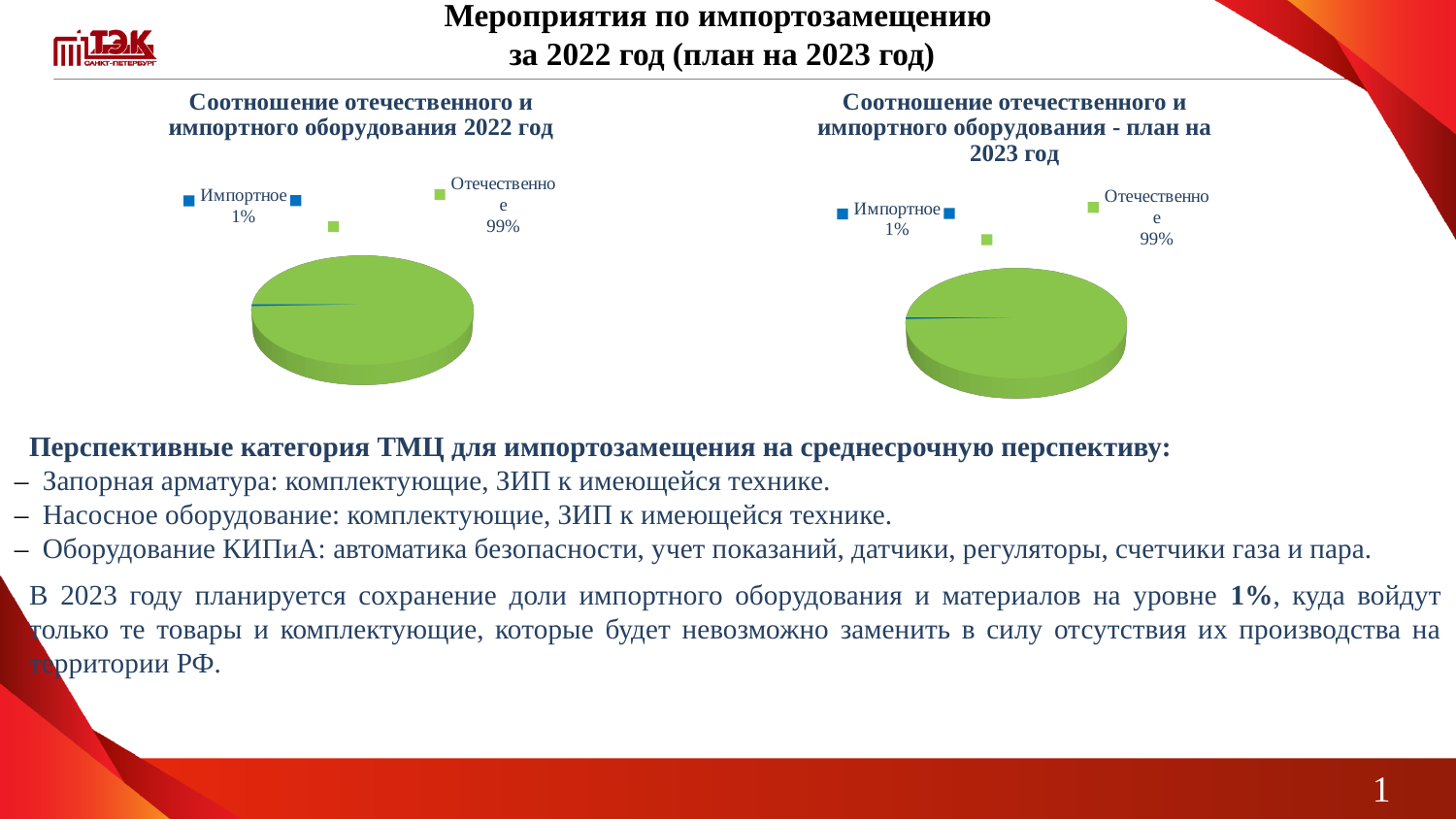
In the right chart (план на 2023 год), what share does Импортное have? 1% What is the title of the right chart? Соотношение отечественного и импортного оборудования - план на 2023 год In the right chart (план на 2023 год), which is larger: Импортное or Отечественное? Отечественное How many categories does the right chart (план на 2023 год) show? 2 In the right chart (план на 2023 год), what share does Отечественное have? 99% In the left chart (Соотношение отечественного и импортного оборудования 2022 год), what share does Импортное have? 1% In the left chart (2022 год), which category has the largest share? Отечественное In the left chart (2022 год), what colour is the Отечественное slice? Green In the right chart (план на 2023 год), which category has the smallest share? Импортное In the left chart (2022 год), what is the difference between the shares of Отечественное and Импортное? 98% What type of chart is the left chart (2022 год)? Pie chart